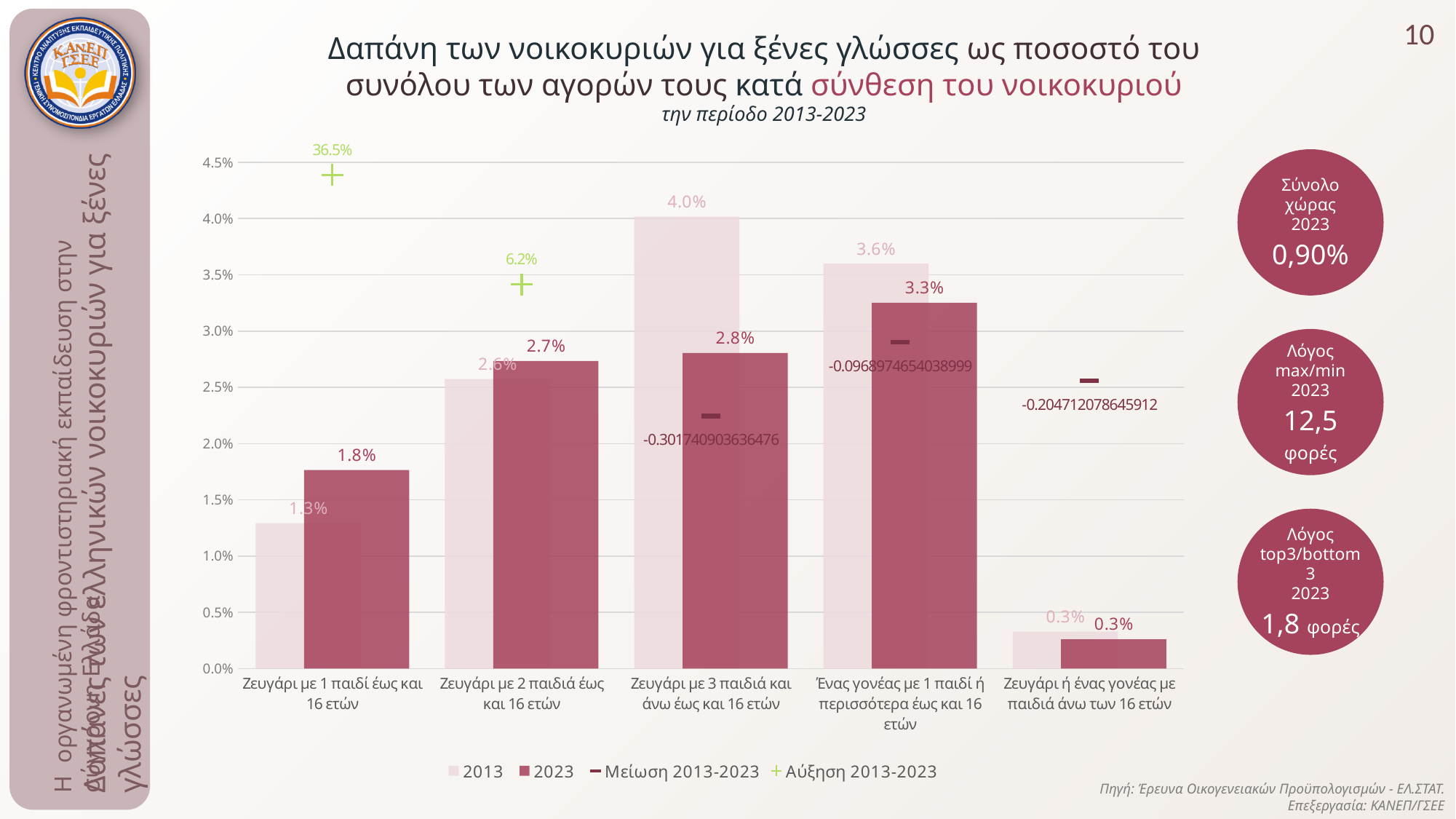
What percentage increase (Αύξηση 2013-2023) is shown for 'Ζευγάρι με 2 παιδιά έως και 16 ετών'? 6.2% What type of chart is shown on the slide? bar chart What is the 2023 value for 'Ζευγάρι με 1 παιδί έως και 16 ετών'? 1.8% Which category has the highest 2013 value? Ζευγάρι με 3 παιδιά και άνω έως και 16 ετών Which is larger for 'Ζευγάρι με 1 παιδί έως και 16 ετών': the 2013 value or the 2023 value? 2023 Which category has the lowest 2023 value? Ζευγάρι ή ένας γονέας με παιδιά άνω των 16 ετών How many household composition categories are shown on the x axis? 5 What is the 2013 value for 'Ζευγάρι με 3 παιδιά και άνω έως και 16 ετών'? 4.0% What is the difference between the 2013 and 2023 values for 'Ζευγάρι με 3 παιδιά και άνω έως και 16 ετών'? 1.2% What value is shown in the 'Σύνολο χώρας 2023' circle on the right of the slide? 0,90% What is the 2023 value for 'Ένας γονέας με 1 παιδί ή περισσότερα έως και 16 ετών'? 3.3% How many entries does the legend list? 4